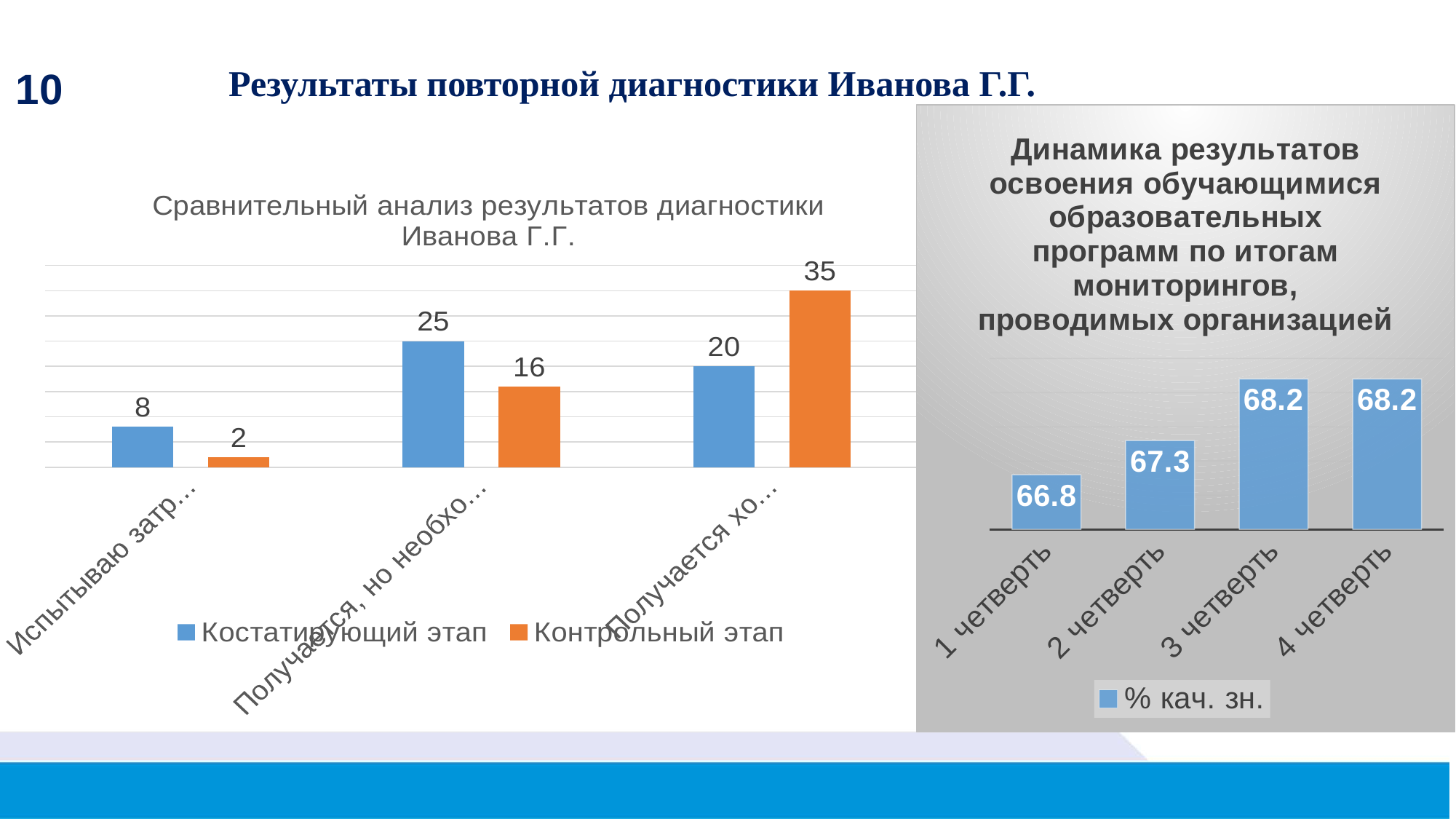
On the right chart (Динамика результатов освоения…), what is the value for 2 четверть? 67.3 On the right chart, how many quarters are shown on the x axis? 4 How many series does the legend of the left chart list? 2 On the left chart, what is the value for Костатирующий этап in the first category (Испытываю затр…)? 8 On the right chart, what is the difference between the values for 3 четверть and 1 четверть? 1.4 On the left chart, which category has the highest value for Костатирующий этап? Получается, но необхо… On the left chart, what is the difference between Костатирующий этап and Контрольный этап in the first category (Испытываю затр…)? 6 On the right chart, which quarter has the lowest value? 1 четверть On the left chart, in the third category (Получается хо…), which series has the larger value, Костатирующий этап or Контрольный этап? Контрольный этап On the left chart, what is the value for Контрольный этап in the second category (Получается, но необхо…)? 16 What type of chart is the left chart? Bar chart On the left chart (Сравнительный анализ результатов диагностики Иванова Г.Г.), what is the value for Контрольный этап in the third category (Получается хо…)? 35